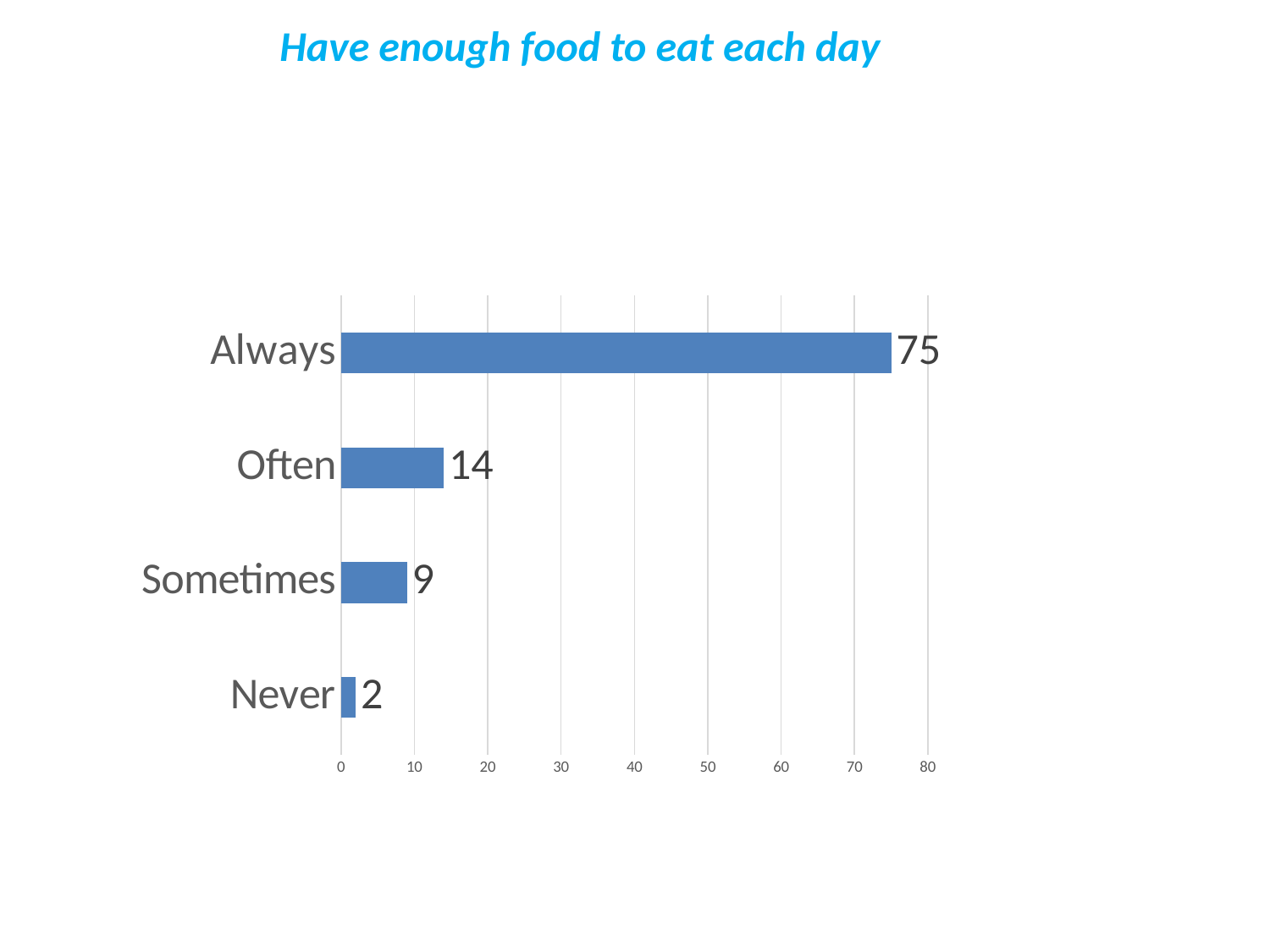
What is the difference between the values for Always and Often? 61 What is the value for Often? 14 How many categories are shown in the chart? 4 What is the value for Never? 2 Which is larger, the value for Sometimes or the value for Never? Sometimes What is the value for Sometimes? 9 What kind of chart is shown on the slide? bar chart Which category has the highest value? Always Is the value for Always greater or less than 70? greater Which category has the lowest value? Never What is the value for Always? 75 What is the difference between the values for Often and Sometimes? 5